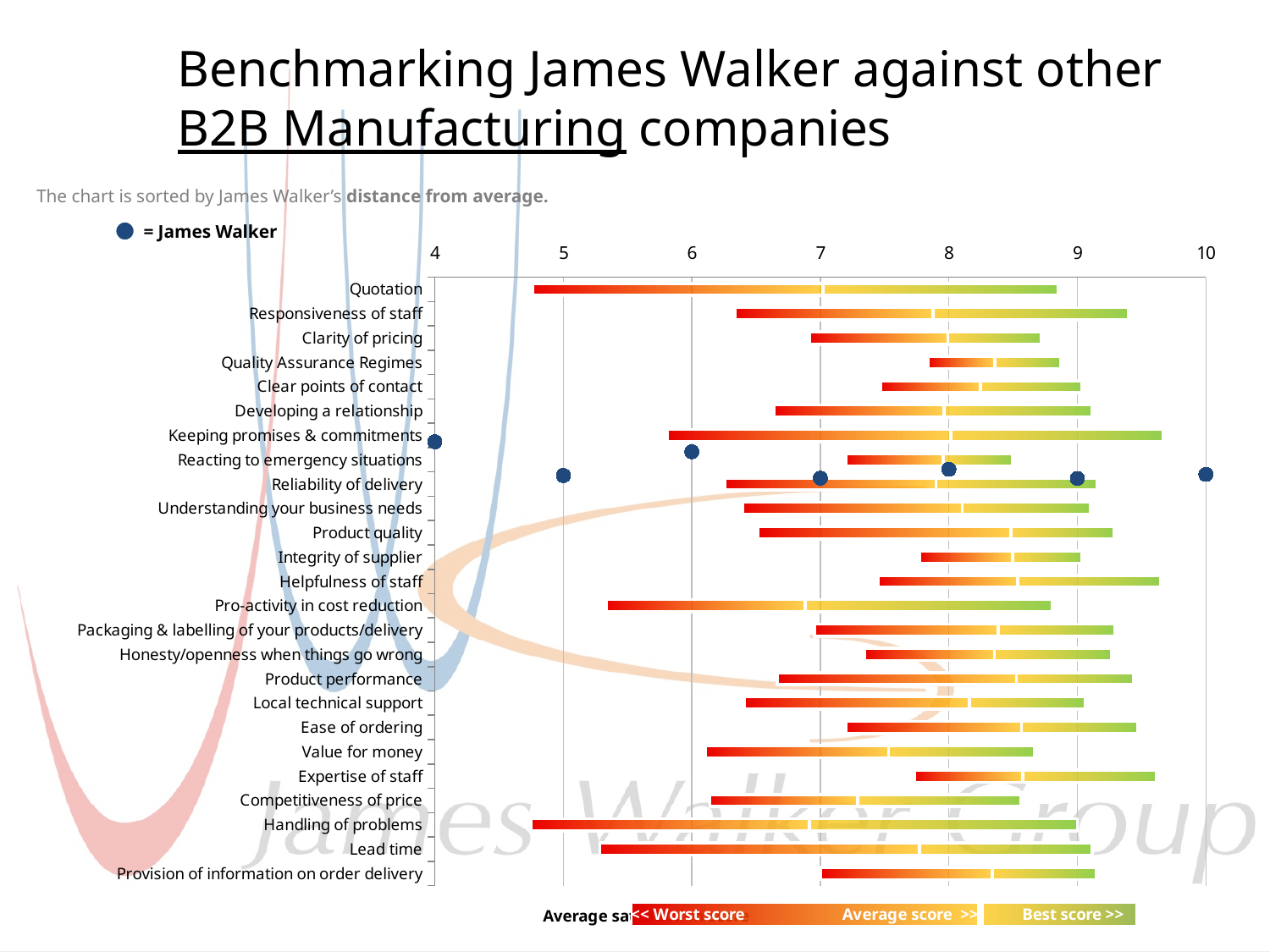
Is the best score for Keeping promises & commitments greater or less than 9? greater Which has the higher best score: Responsiveness of staff or Clarity of pricing? Responsiveness of staff Is the best score for Competitiveness of price greater or less than 9? less How many categories (attributes) are listed on the vertical axis of the chart? 25 Is the worst score for Quotation greater or less than 5? less Which has the higher worst score: Quality Assurance Regimes or Quotation? Quality Assurance Regimes What kind of chart is shown on the slide? Bar chart According to the note above the chart, what is the chart sorted by? James Walker's distance from average What is the first category listed at the top of the chart? Quotation